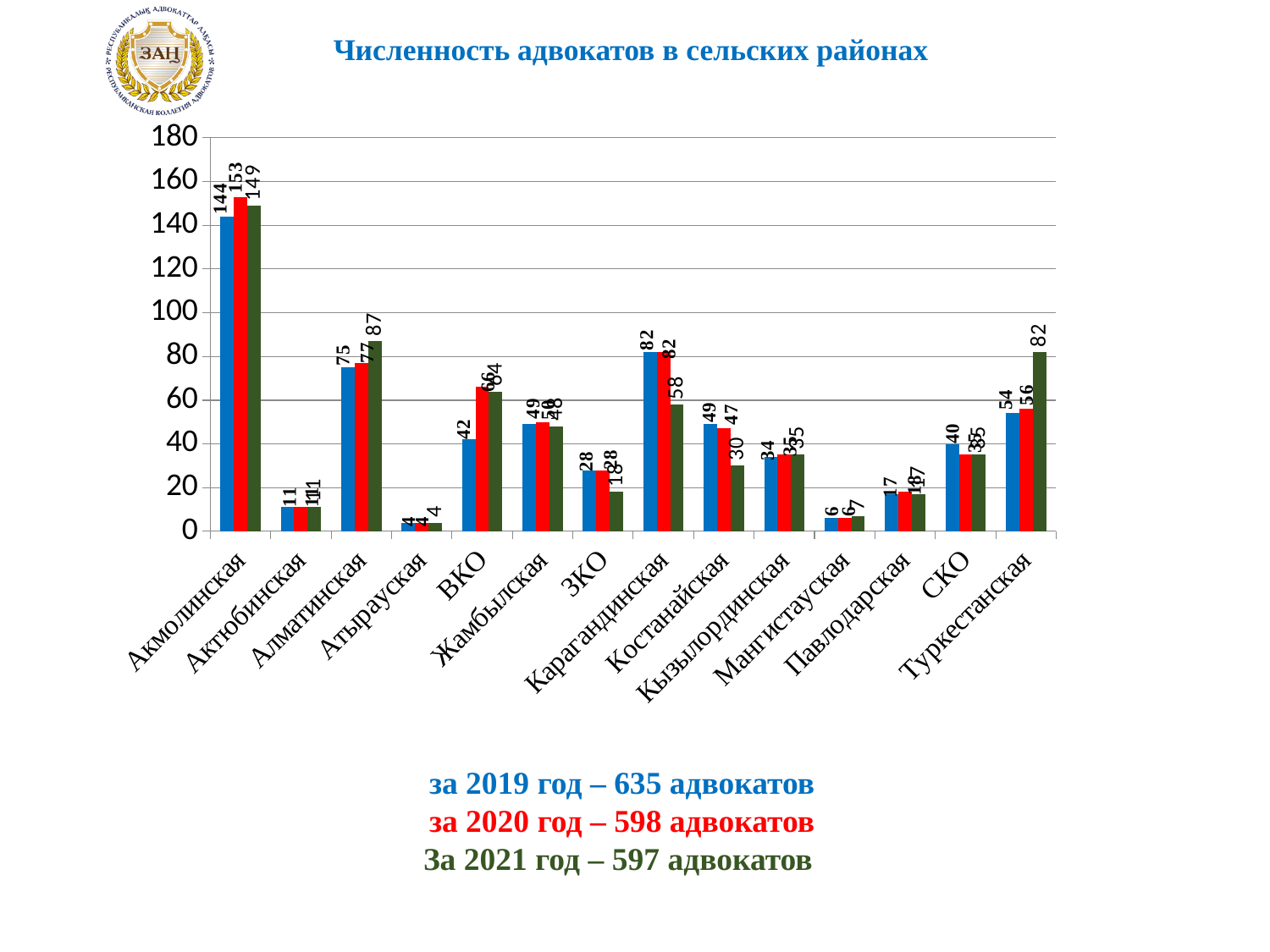
Which region has the lowest bars in the chart? Атырауская Is the value of the green (2021) bar for Костанайская greater or less than 40? less What is the value of the green (2021) bar for Алматинская? 87 Do the bars for Туркестанская rise or fall from the blue (2019) bar to the green (2021) bar? rise What is the value of the green (2021) bar for Туркестанская? 82 What is the value of the blue (2019) bar for Акмолинская? 144 How many regions (categories) are shown along the x axis of the chart? 14 Which region has the highest red (2020) bar? Акмолинская What is the title of the chart? Численность адвокатов в сельских районах Which is larger: the green (2021) bar for Алматинская or the green (2021) bar for Карагандинская? Алматинская What kind of chart is shown on the slide? bar chart What is the difference between the red (2020) bar and the blue (2019) bar for Акмолинская? 9